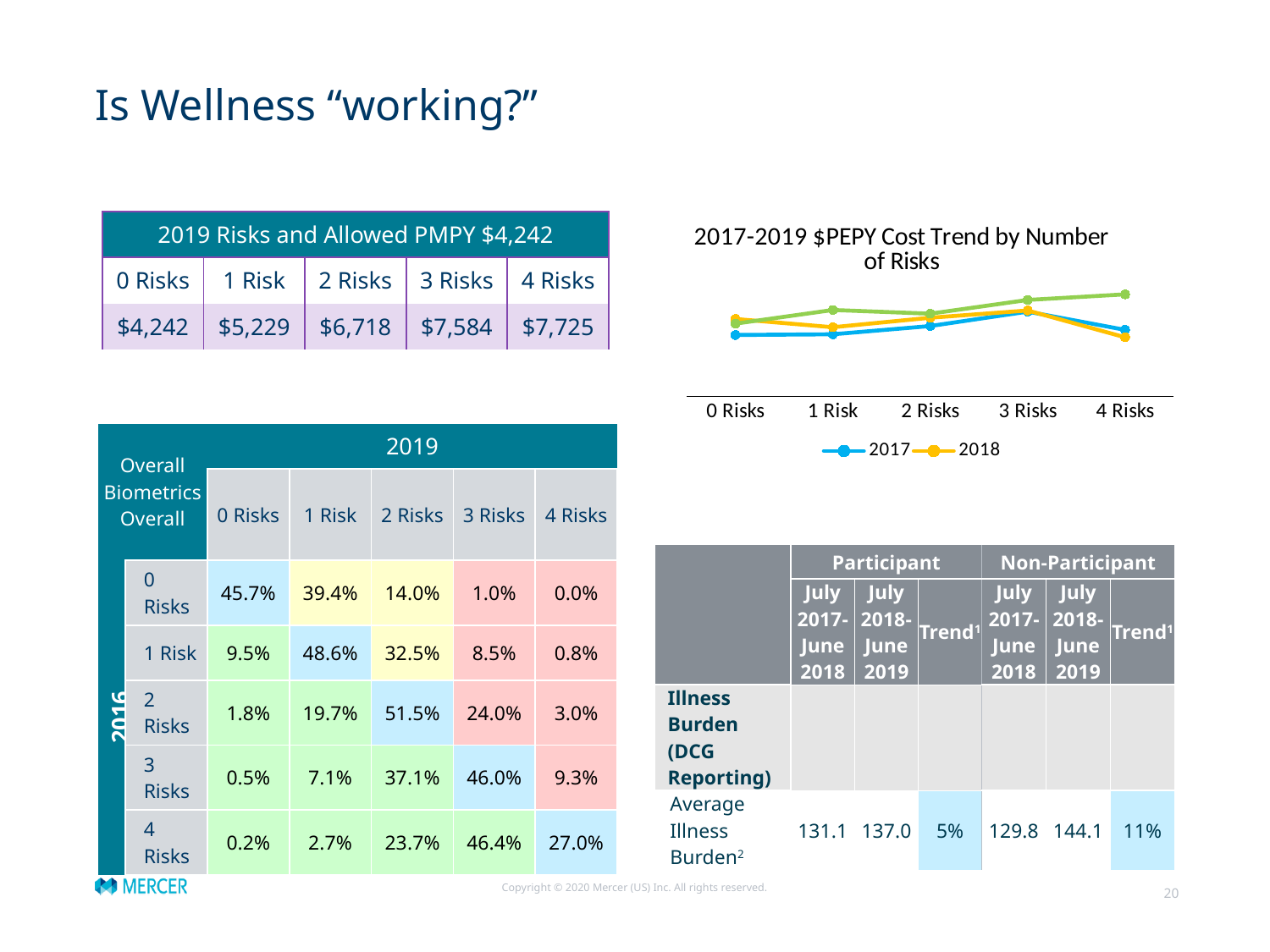
At 0 Risks, which line is lower: the 2017 line or the 2018 line? 2017 What kind of chart is shown on the slide? line chart At 4 Risks, which line is higher: the 2017 line or the 2018 line? 2017 How many series does the chart's legend list? 2 Which series does the legend show in blue? 2017 What is the title of the chart on the slide? 2017-2019 $PEPY Cost Trend by Number of Risks Does the 2018 line rise or fall from 3 Risks to 4 Risks? fall At which number of risks does the 2017 line reach its highest point? 3 Risks At 4 Risks, which line is higher: the green line or the 2017 line? green line How many categories are shown along the x axis of the chart? 5 Does the green line rise or fall from 0 Risks to 4 Risks? rise At which number of risks does the 2018 line reach its lowest point? 4 Risks